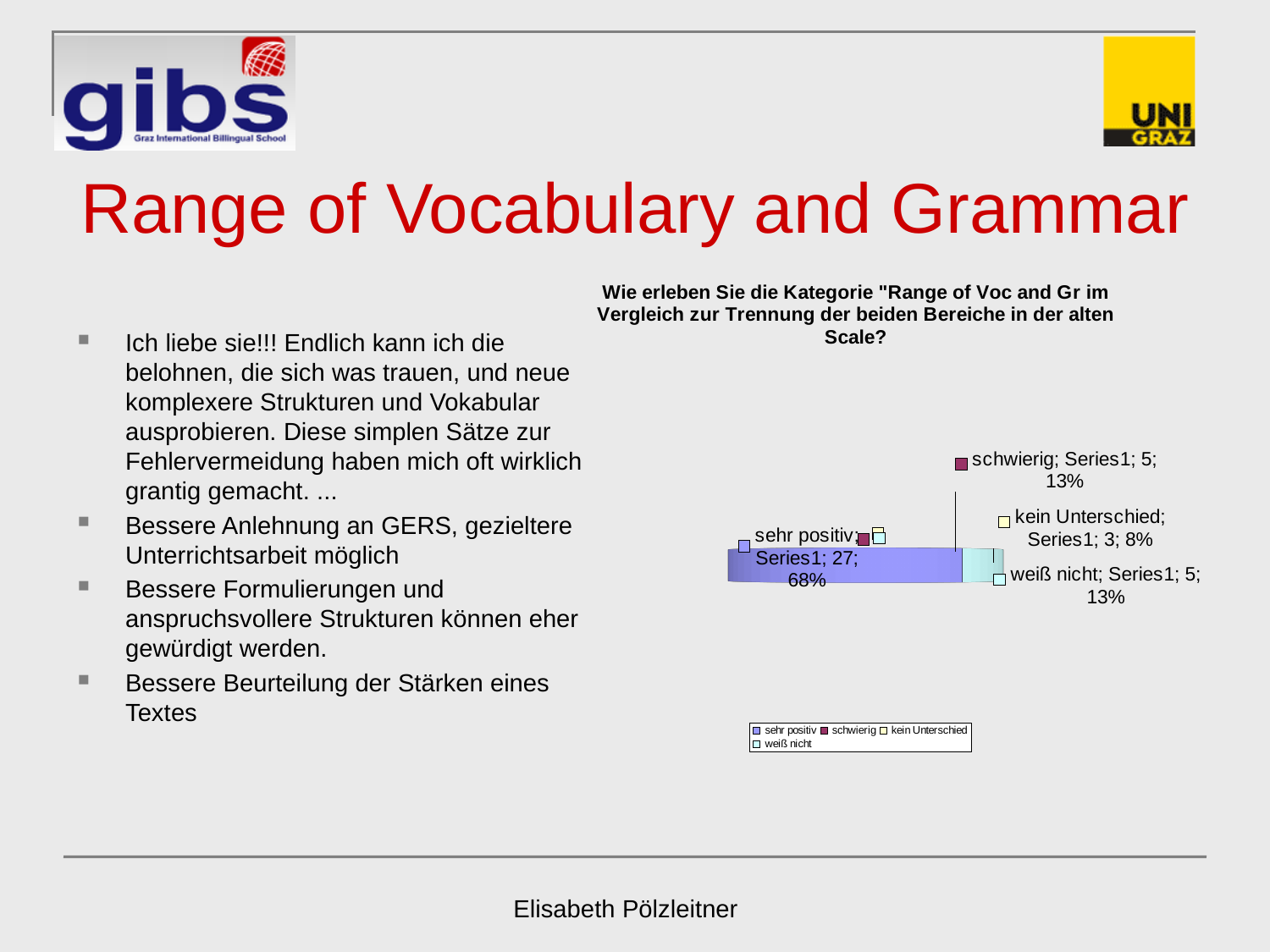
What kind of chart is shown on the slide? pie chart How many entries does the chart legend list? 4 What percentage share does "weiß nicht" have in the pie chart? 13% What is the value for "sehr positiv" in the pie chart? 27 What percentage share does "sehr positiv" have in the pie chart? 68% What is the value for "kein Unterschied" in the pie chart? 3 Which category has the smallest slice in the pie chart? kein Unterschied How many categories are shown in the pie chart? 4 What is the value for "schwierig" in the pie chart? 5 Which is larger, the value for "schwierig" or the value for "kein Unterschied"? schwierig Which category has the largest slice in the pie chart? sehr positiv What is the difference between the values for "sehr positiv" and "schwierig"? 22